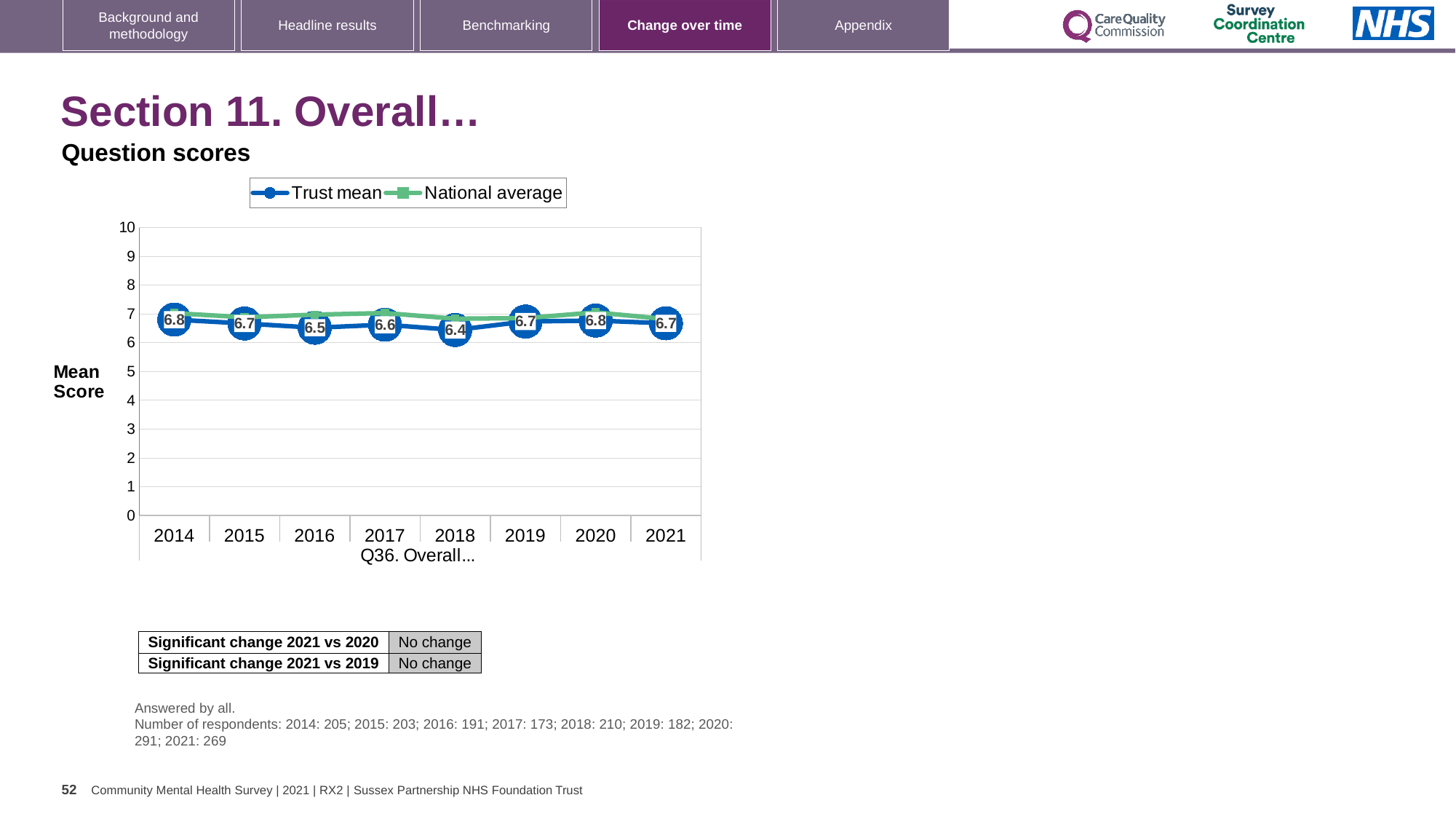
What is the Trust mean for 2021? 6.7 Does the Trust mean rise or fall from 2018 to 2020? rise How many years are shown on the x axis? 8 How many series does the legend list? 2 Is the National average value for 2018 greater or less than 5? greater What is the Trust mean for 2018? 6.4 What is the difference between the Trust mean in 2014 and in 2018? 0.4 What is the label on the y axis of the chart? Mean Score What type of chart is shown on the slide? line chart In which year is the Trust mean lowest? 2018 Which is larger, the Trust mean in 2017 or in 2020? 2020 What is the Trust mean for 2016? 6.5